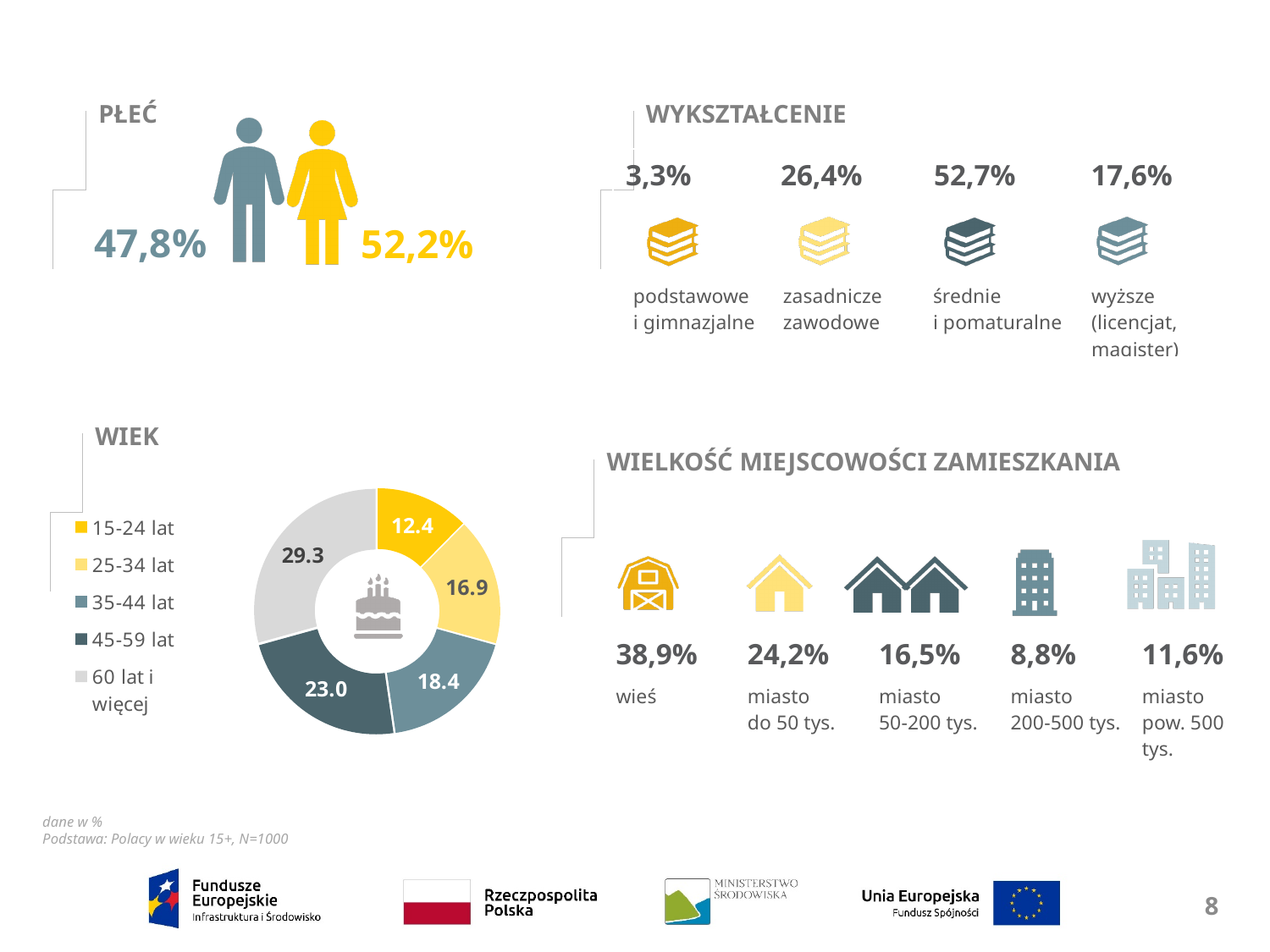
In the WIEK chart, what share of the whole does the 60 lat i więcej segment represent? 29.3 What is the title of the chart with the age groups? WIEK How many age groups are shown in the WIEK chart? 5 In the WIEK chart, which age group has the largest segment? 60 lat i więcej What type of chart is the WIEK chart? Donut (pie) chart In the WIEK chart, which age group has the smallest segment? 15-24 lat In the WIEK chart, what is the value for the 35-44 lat segment? 18.4 In the WIEK chart, which is larger: the 25-34 lat segment or the 35-44 lat segment? 35-44 lat In the WIEK chart, what is the value for the 45-59 lat segment? 23.0 In the WIEK chart, what is the difference between the 60 lat i więcej segment and the 15-24 lat segment? 16.9 In the WIEK chart, what is the value for the 15-24 lat segment? 12.4 In the WIEK chart, what is the difference between the 45-59 lat segment and the 35-44 lat segment? 4.6